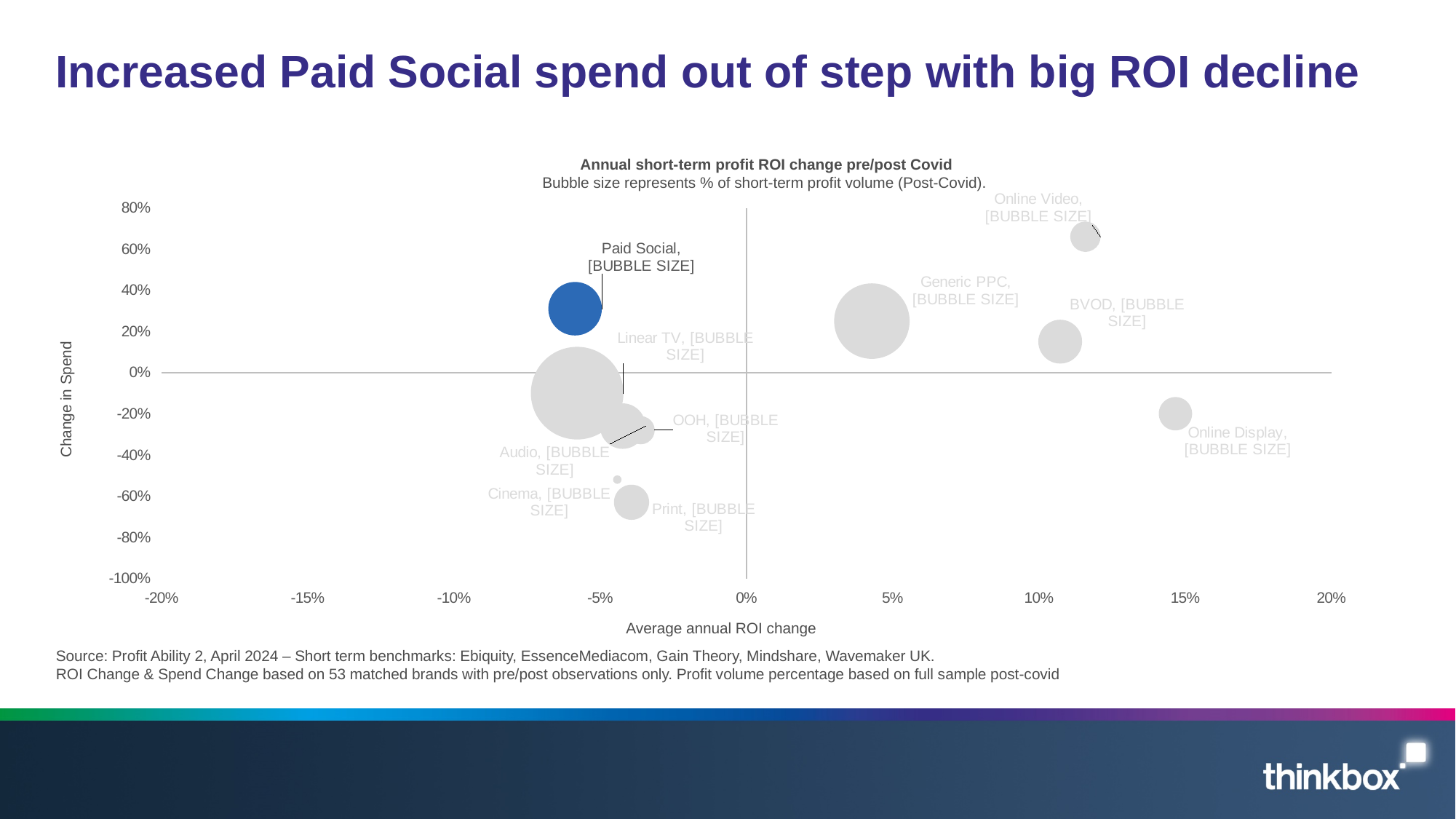
Which channel has the largest bubble on the chart? Linear TV What kind of chart is shown on the slide? Bubble chart Is the change in spend for Paid Social greater or less than 20%? greater Which channel has a higher change in spend, Online Video or BVOD? Online Video Is the change in spend for Online Display greater or less than 0%? less Which channel has the highest average annual ROI change on the chart? Online Display Is the average annual ROI change for Paid Social greater or less than 0%? less How many media channels are plotted as bubbles on the chart? 10 Which bubble is highlighted in blue on the chart? Paid Social Which channel has the highest change in spend on the chart? Online Video Which channel has the lowest change in spend on the chart? Print